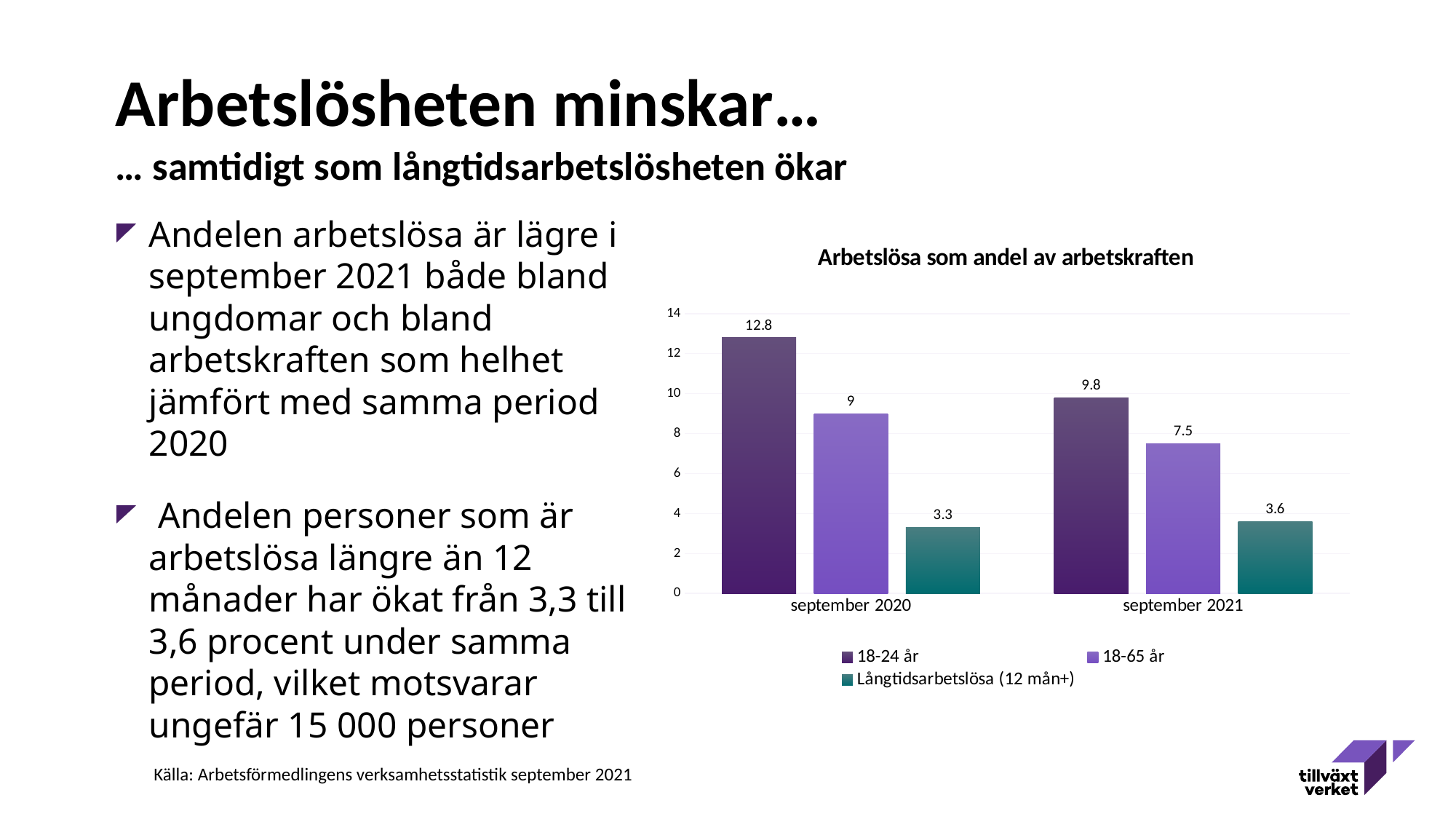
What is the value for 18-24 år in september 2020? 12.8 How many series does the legend list? 3 What is the value for 18-65 år in september 2021? 7.5 What kind of chart is shown on the slide? bar chart Which series has the highest value in september 2021? 18-24 år How many categories are shown on the x axis? 2 What is the difference between the 18-24 år values for september 2020 and september 2021? 3 What is the value for Långtidsarbetslösa (12 mån+) in september 2020? 3.3 What is the title of the chart? Arbetslösa som andel av arbetskraften Which series has the lowest value in september 2020? Långtidsarbetslösa (12 mån+) Which is larger: the 18-65 år value in september 2020 or in september 2021? september 2020 Is the value for 18-24 år in september 2021 greater or less than 8? greater